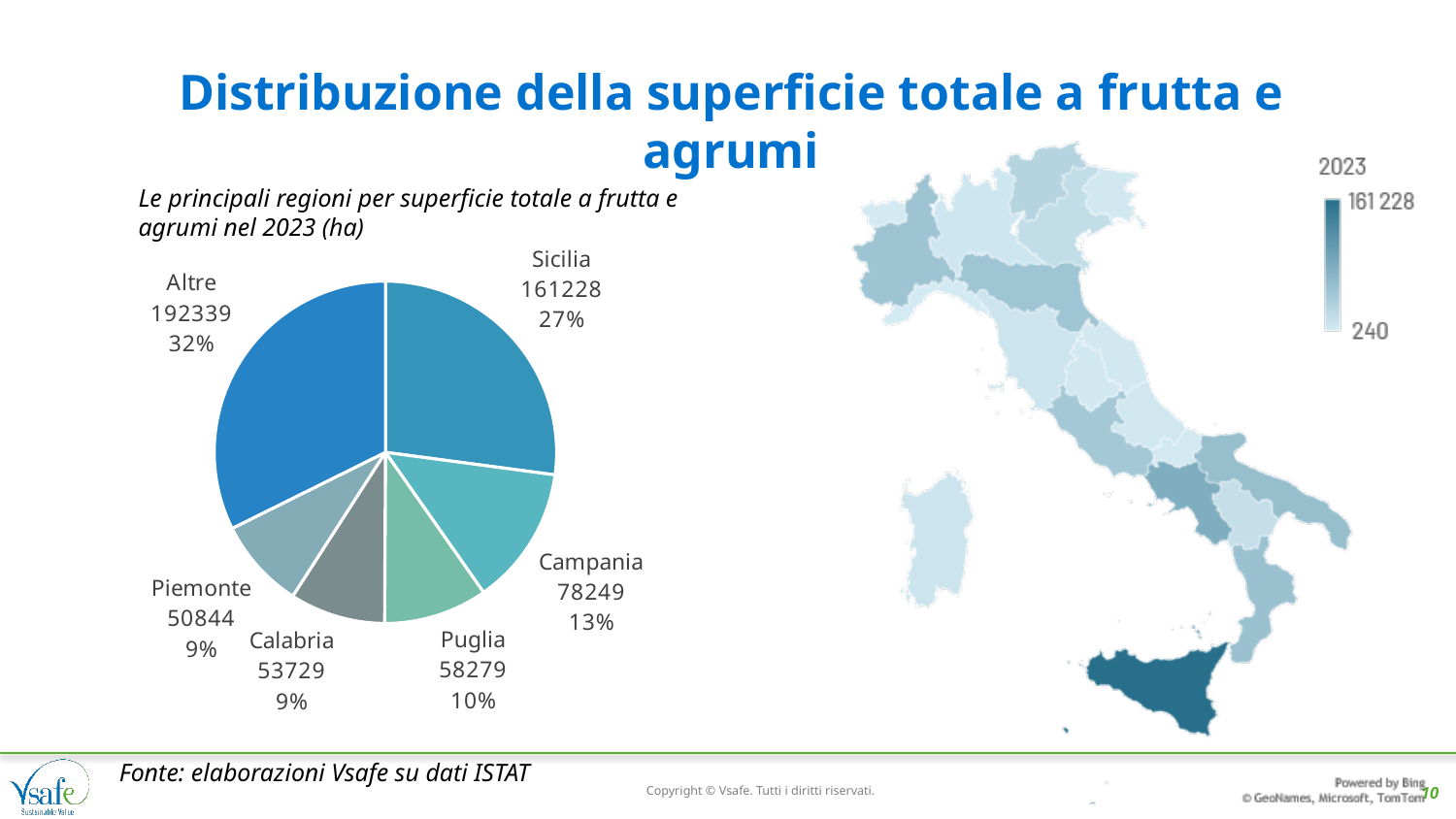
In the pie chart on the left, what share of the pie does Campania have? 13% How many slices does the pie chart on the left have? 6 In the pie chart on the left, what share of the pie does Altre have? 32% In the pie chart on the left, which slice is the smallest? Piemonte In the pie chart on the left, which named region (excluding Altre) has the largest slice? Sicilia In the pie chart on the left, what is the difference between the values for Campania and Puglia? 19970 On the map on the right, what is the maximum value shown on the colour legend? 161 228 On the map on the right, what is the minimum value shown on the colour legend? 240 In the pie chart on the left, what is the value for Piemonte? 50844 In the pie chart on the left, what is the value for Sicilia? 161228 In the pie chart on the left, which is larger, the value for Calabria or the value for Piemonte? Calabria What kind of chart is shown on the left of the slide? Pie chart